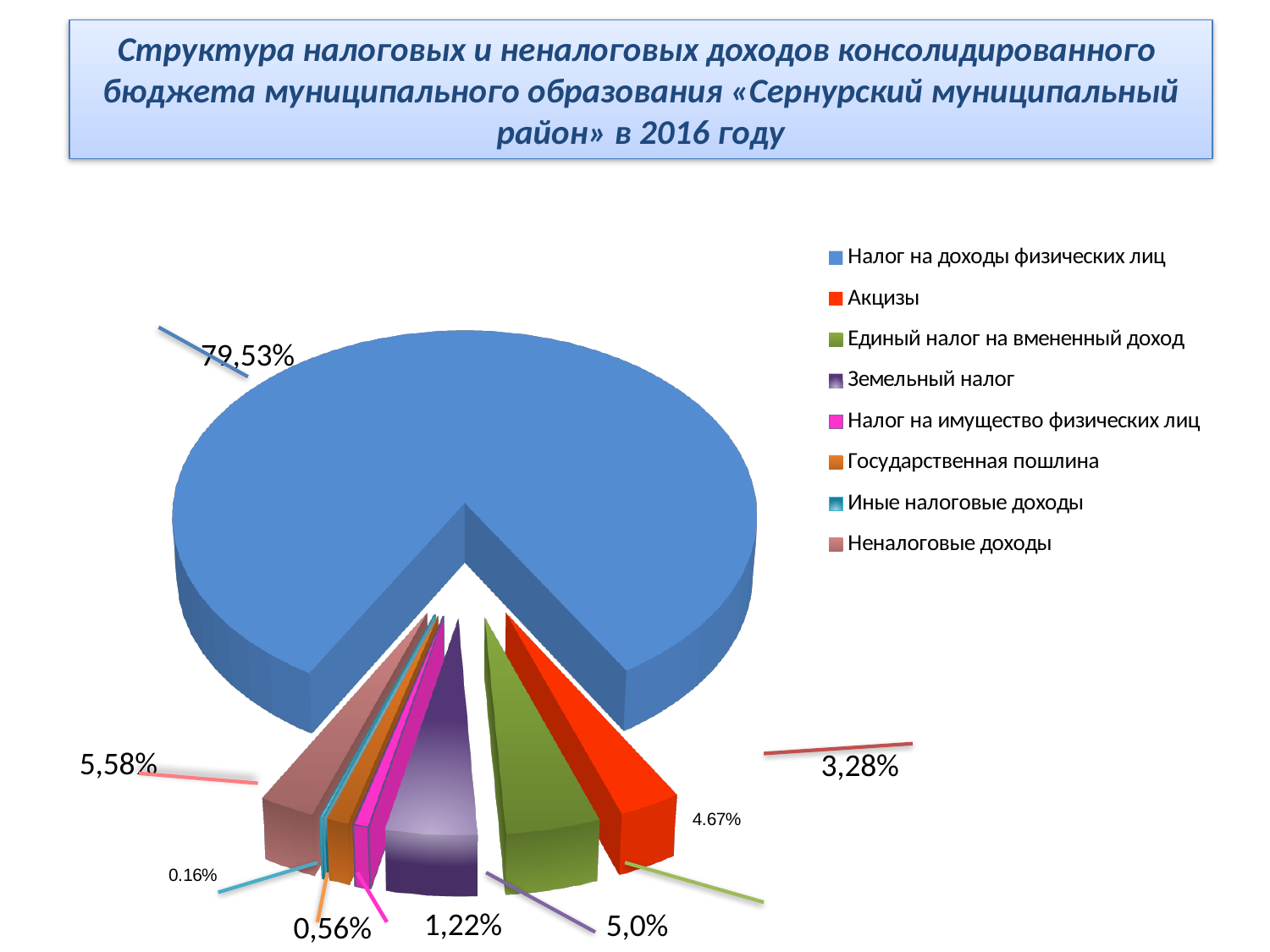
What is the difference between the share for Налог на доходы физических лиц (79,53%) and the share for Единый налог на вмененный доход (5,0%)? 74,53% What is the smallest percentage label shown on the pie chart? 0.16% Which year does the chart title say the data refers to? 2016 What share is labelled for Неналоговые доходы? 5,58% What share is labelled for Земельный налог? 1,22% Is the share for Налог на доходы физических лиц greater or less than 50%? greater What share is labelled for Единый налог на вмененный доход? 5,0% Which category has the largest share of the pie? Налог на доходы физических лиц How many categories does the legend of the pie chart list? 8 What kind of chart is shown on the slide? pie chart What is the share shown for the largest slice of the pie? 79,53%